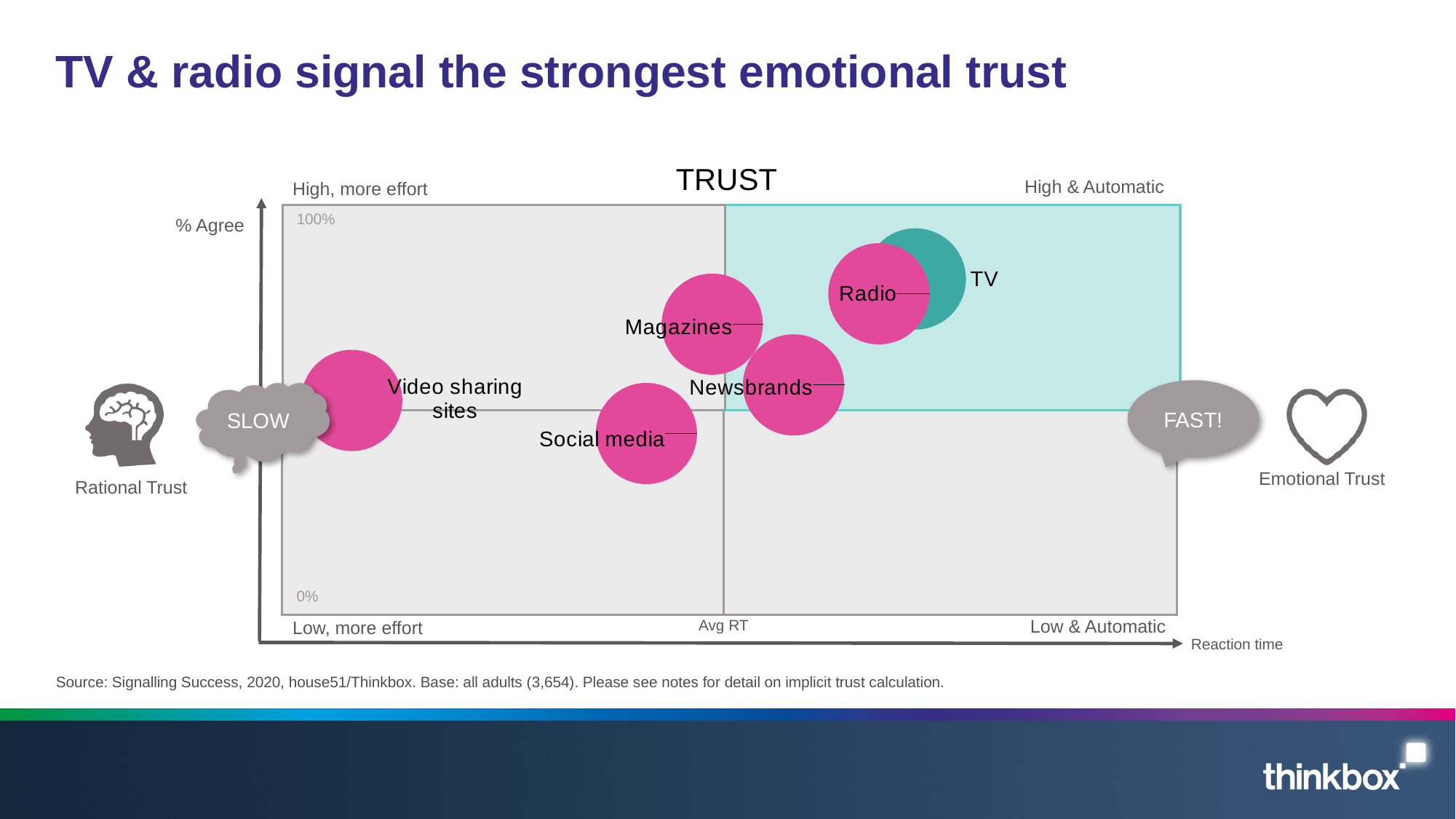
How many media categories are plotted as bubbles on the chart? 6 What is the label of the horizontal axis of the chart? Reaction time What kind of chart is shown on the slide? Bubble (scatter) chart Which has a higher % Agree, Magazines or Social media? Magazines Which category is positioned furthest to the left (slowest reaction time) on the chart? Video sharing sites Which category has the lowest % Agree on the chart? Social media Which has a higher % Agree, Radio or Video sharing sites? Radio What is the label of the vertical axis of the chart? % Agree Which category is positioned furthest to the right (fastest reaction time) on the chart? TV Is the Social media bubble to the left or right of the Avg RT line? Left